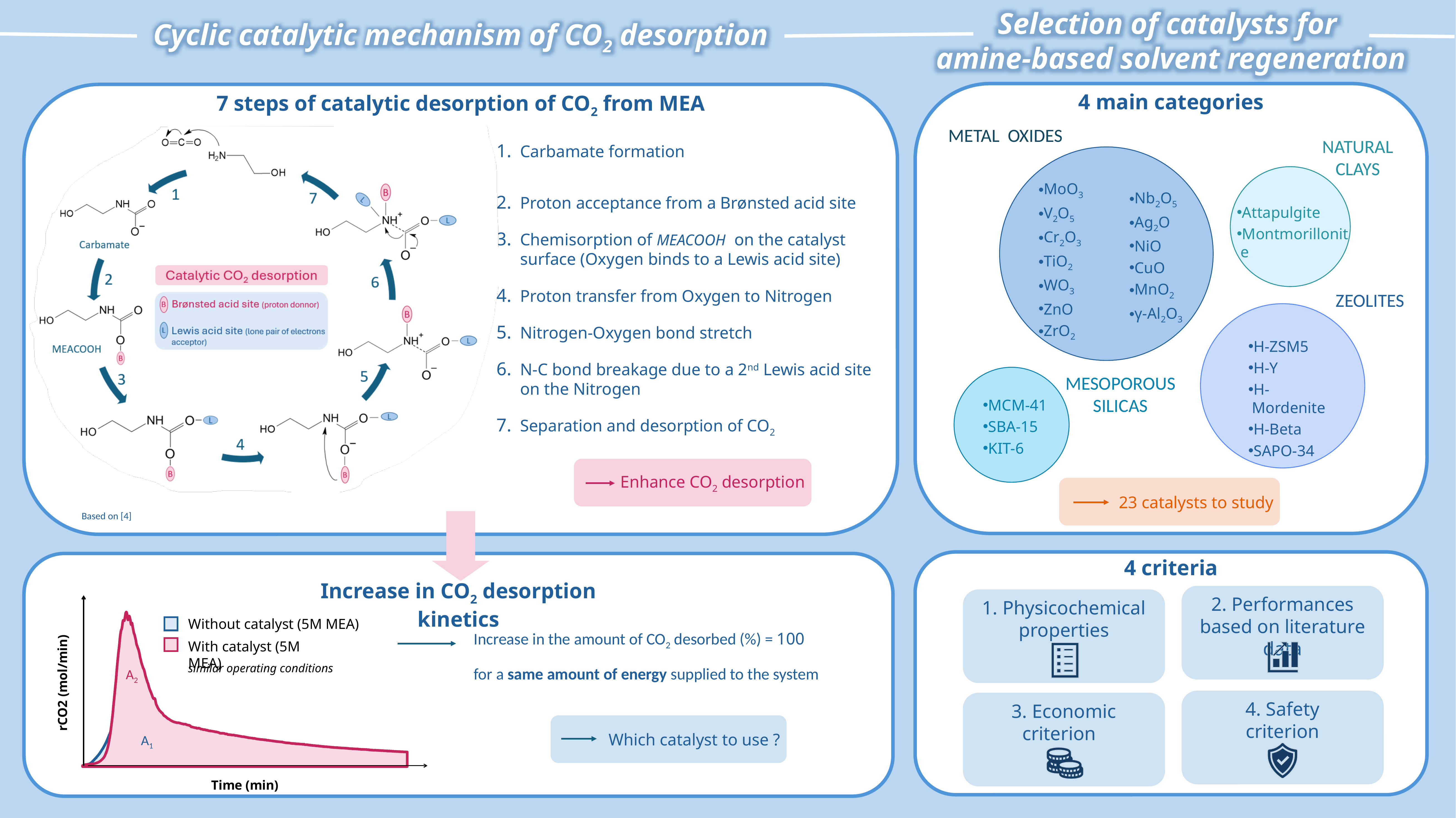
In the bottom-left chart, after reaching its peak, does the 'With catalyst (5M MEA)' curve rise or fall as time increases? fall In the bottom-left chart, which series is drawn in pink/red? With catalyst (5M MEA) What is the label of the x axis of the bottom-left chart? Time (min) What are the two area labels written inside the shaded region of the bottom-left chart? A2 and A1 How many series does the legend of the bottom-left chart list? 2 In the bottom-left chart, does the 'With catalyst (5M MEA)' curve rise or fall at the very start, before its peak? rise In the bottom-left chart, which series is drawn in blue? Without catalyst (5M MEA) What kind of chart is shown in the bottom-left panel of the slide? line chart What is the label of the y axis of the bottom-left chart? rCO2 (mol/min)